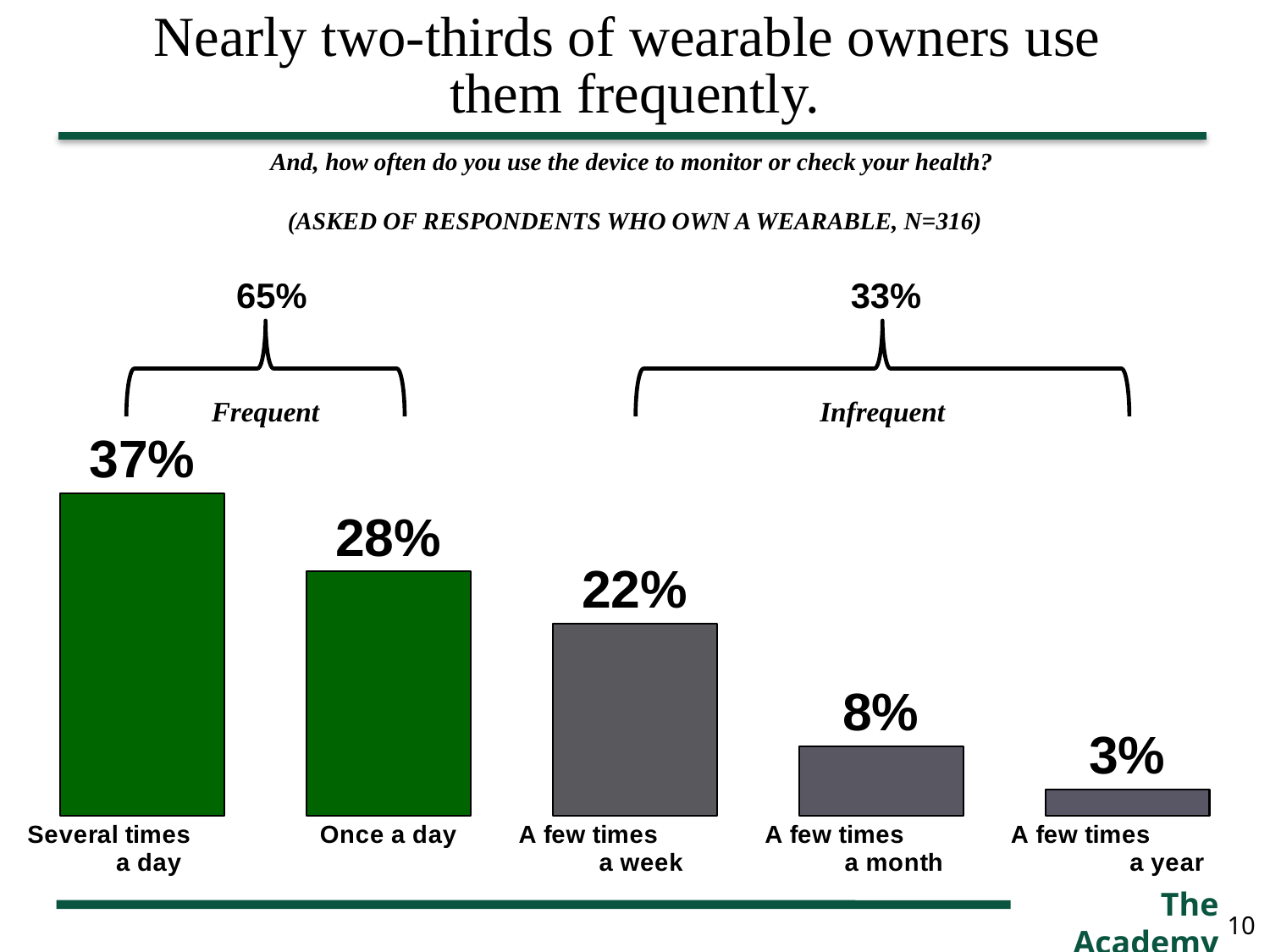
Which is larger, the percentage for 'A few times a week' or 'A few times a month'? A few times a week Do the values rise or fall moving from left to right across the categories? Fall What percentage of wearable owners use the device once a day? 28% What kind of chart is shown on the slide? Bar chart Which usage frequency category has the lowest percentage? A few times a year What is the difference in percentage points between 'Several times a day' and 'Once a day'? 9 What percentage of wearable owners use the device several times a day? 37% What percentage of wearable owners use the device a few times a year? 3% How many usage frequency categories are shown in the chart? 5 What combined percentage is shown for the 'Frequent' group? 65% What percentage of wearable owners use the device a few times a week? 22% Which usage frequency category has the highest percentage? Several times a day